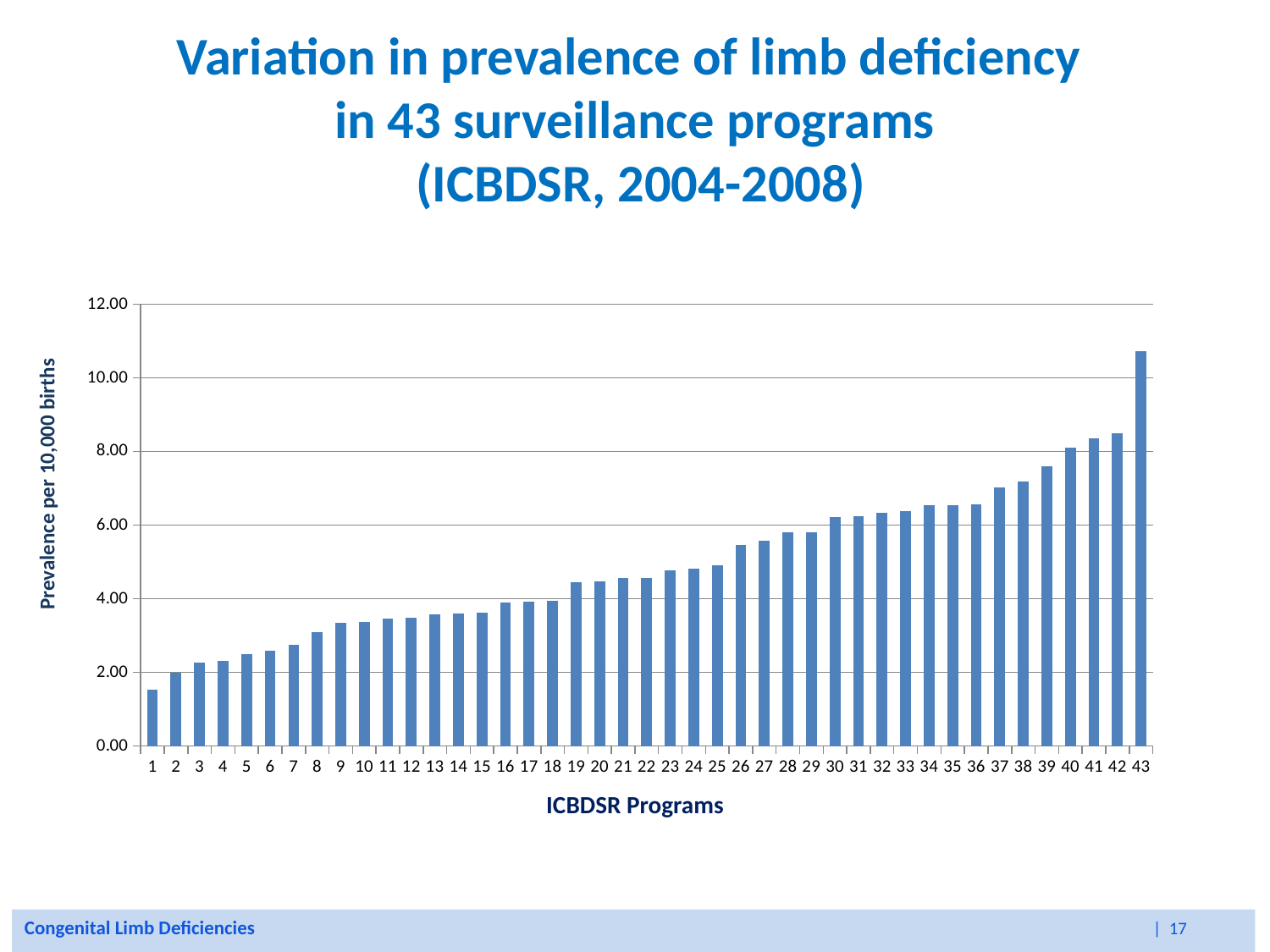
Which program has the lowest prevalence per 10,000 births? 1 Which program has the highest prevalence per 10,000 births? 43 What is the label of the y axis? Prevalence per 10,000 births How many ICBDSR programs are plotted on the x axis? 43 Is the value for program 25 greater or less than 6.00? less Is the value for program 10 greater or less than 4.00? less Which has the larger prevalence, program 1 or program 2? program 2 What kind of chart is shown on the slide? bar chart Is the value for program 43 greater or less than 10.00? greater Do the prevalence values rise or fall from program 1 to program 43? rise